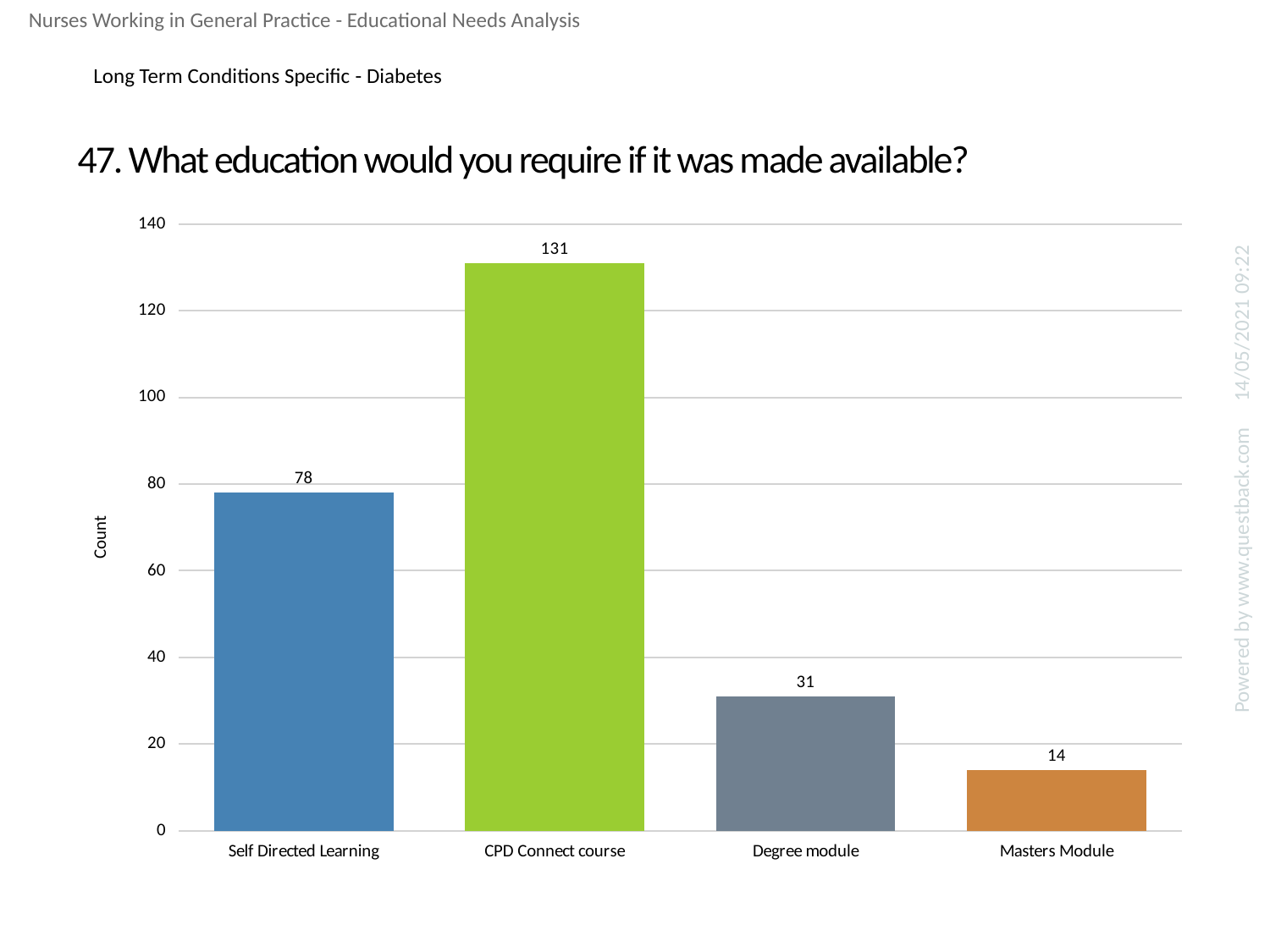
Which education option has the highest count? CPD Connect course What kind of chart is shown on the slide? Bar chart Which has a larger count, Self Directed Learning or Degree module? Self Directed Learning What is the label on the vertical axis of the chart? Count What is the difference between the counts for CPD Connect course and Self Directed Learning? 53 What is the count for Degree module? 31 Which education option has the lowest count? Masters Module What is the count for Self Directed Learning? 78 How many education options are shown on the chart? 4 What is the difference between the counts for Degree module and Masters Module? 17 What is the count for Masters Module? 14 What is the count for CPD Connect course? 131